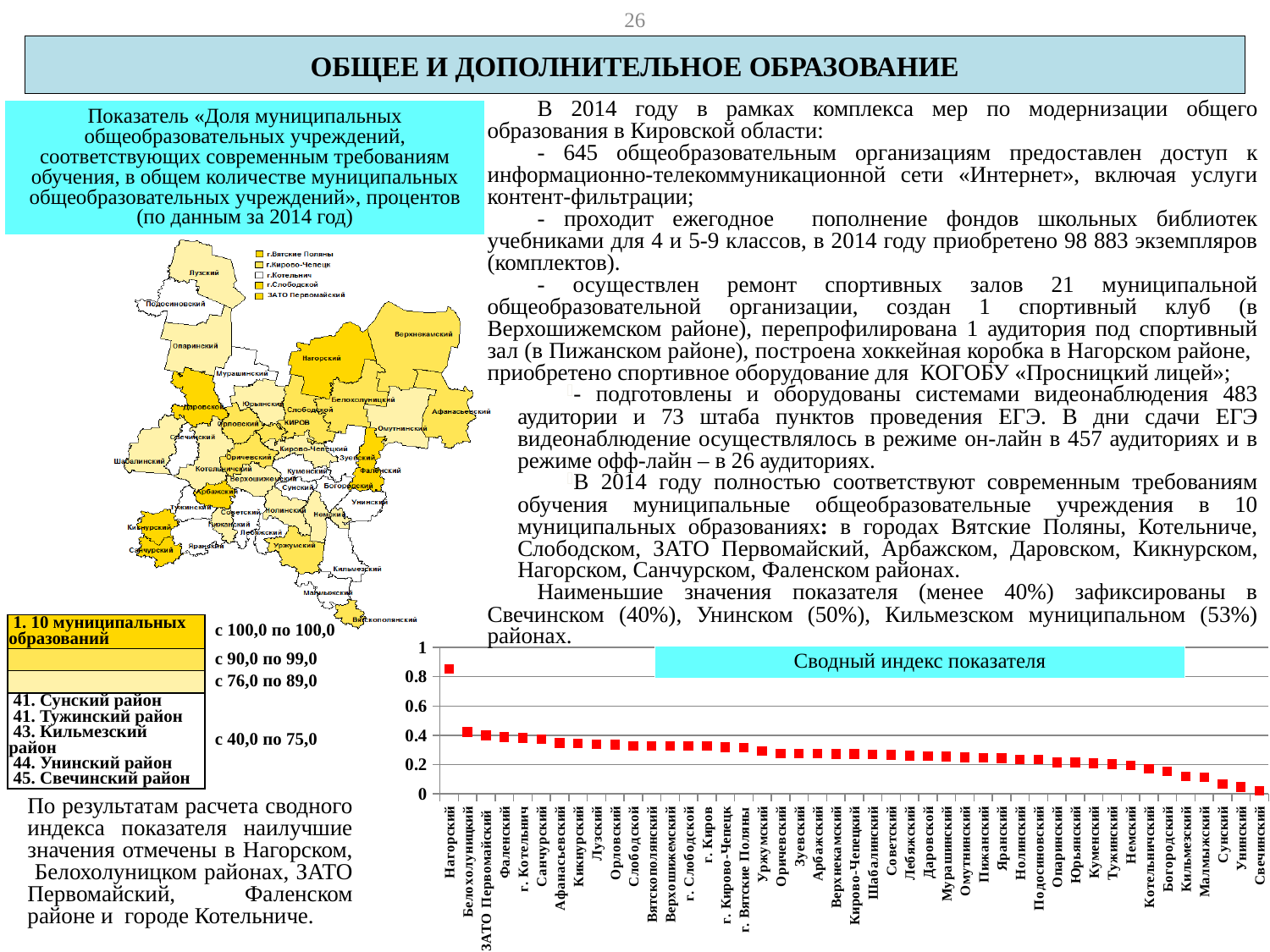
In the 'Сводный индекс показателя' chart, is the value for Унинский greater or less than 0.2? less How many categories are plotted along the x axis of the 'Сводный индекс показателя' chart? 45 In the 'Сводный индекс показателя' chart, which category has the highest value? Нагорский In the 'Сводный индекс показателя' chart, which has the larger value, Нагорский or Белохолуницкий? Нагорский In the 'Сводный индекс показателя' chart, is the value for Нагорский greater or less than 0.8? greater In the 'Сводный индекс показателя' chart, is the value for Свечинский greater or less than 0.2? less What is the title of the chart at the bottom of the slide? Сводный индекс показателя In the 'Сводный индекс показателя' chart, which has the larger value, Фаленский or Кильмезский? Фаленский What kind of chart is the 'Сводный индекс показателя' chart? scatter chart In the 'Сводный индекс показателя' chart, which category has the lowest value? Свечинский In the 'Сводный индекс показателя' chart, do the values rise or fall from left to right along the x axis? fall